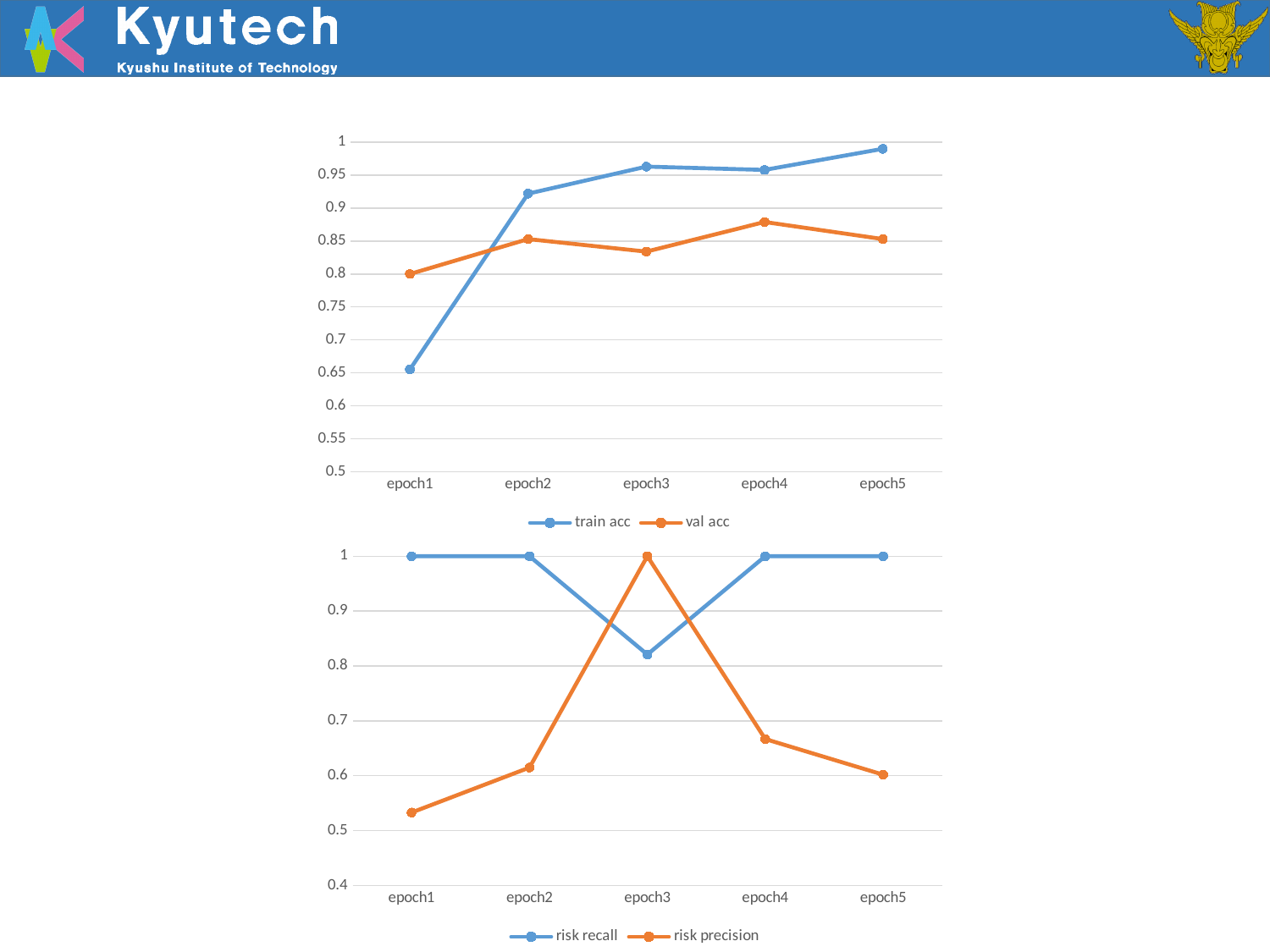
In the bottom chart, what is the value of risk recall at epoch1? 1 In the top chart, is the train acc value at epoch2 greater or less than 0.9? greater In the bottom chart, what is the value of risk precision at epoch3? 1 In the top chart, at which epoch is train acc highest? epoch5 In the top chart, which series has the larger value at epoch1, train acc or val acc? val acc In the bottom chart, is the risk precision value at epoch1 greater or less than 0.6? less How many series does the legend of the bottom chart list? 2 In the top chart, is the train acc value at epoch1 greater or less than 0.7? less How many epochs are plotted along the x axis of the top chart? 5 In the top chart, does train acc generally rise or fall from epoch1 to epoch5? rise In the bottom chart, at which epoch is risk precision lowest? epoch1 What kind of chart is the top chart on the slide? line chart